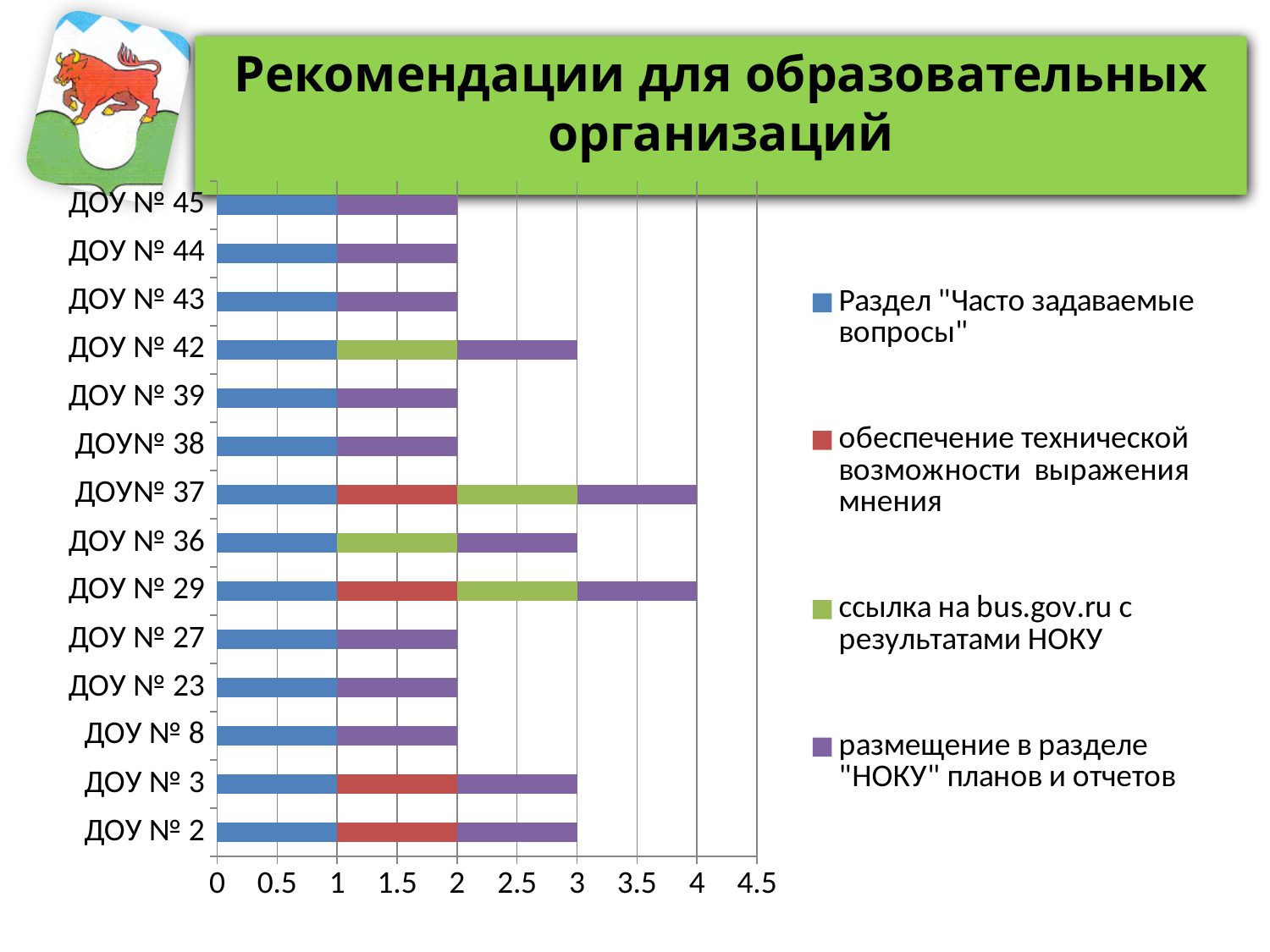
Which legend entry is shown in green? ссылка на bus.gov.ru с результатами НОКУ What is the difference between the total bar lengths of ДОУ № 37 and ДОУ № 8? 2 How many series does the chart legend list? 4 What is the total length of the stacked bar for ДОУ № 29? 4 What is the value of the 'Раздел "Часто задаваемые вопросы"' segment for ДОУ № 2? 1 What kind of chart is shown on the slide? bar chart What is the total length of the stacked bar for ДОУ № 45? 2 Is the total bar length for ДОУ № 3 greater or less than 2? greater What is the total length of the stacked bar for ДОУ № 42? 3 Which stacked bar is longer, ДОУ № 36 or ДОУ № 39? ДОУ № 36 How many categories (ДОУ) are listed on the vertical axis of the chart? 14